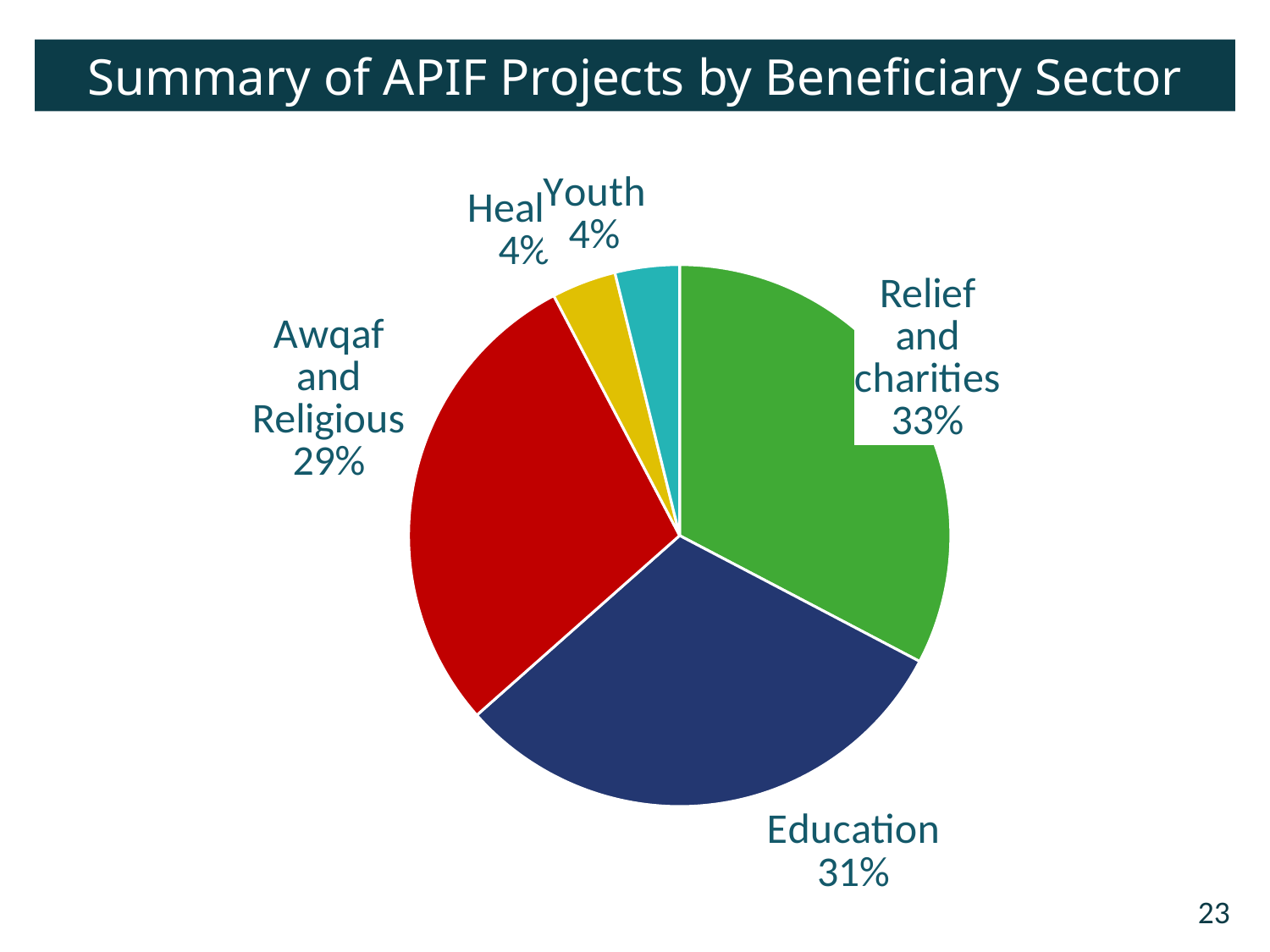
What share is shown for Awqaf and Religious? 29% What percentage of the pie is the Youth slice? 4% What share of APIF projects goes to Relief and charities? 33% Which is larger, the share for Relief and charities or the share for Youth? Relief and charities What is the difference in percentage points between Relief and charities and Education? 2 What is the title of the slide? Summary of APIF Projects by Beneficiary Sector What type of chart is shown on the slide? Pie chart Which is larger, the share for Education or the share for Awqaf and Religious? Education What percentage of the pie is Education? 31% How many slices does the pie chart have? 5 What is the difference in percentage points between Education and Awqaf and Religious? 2 Which beneficiary sector has the largest share of APIF projects? Relief and charities